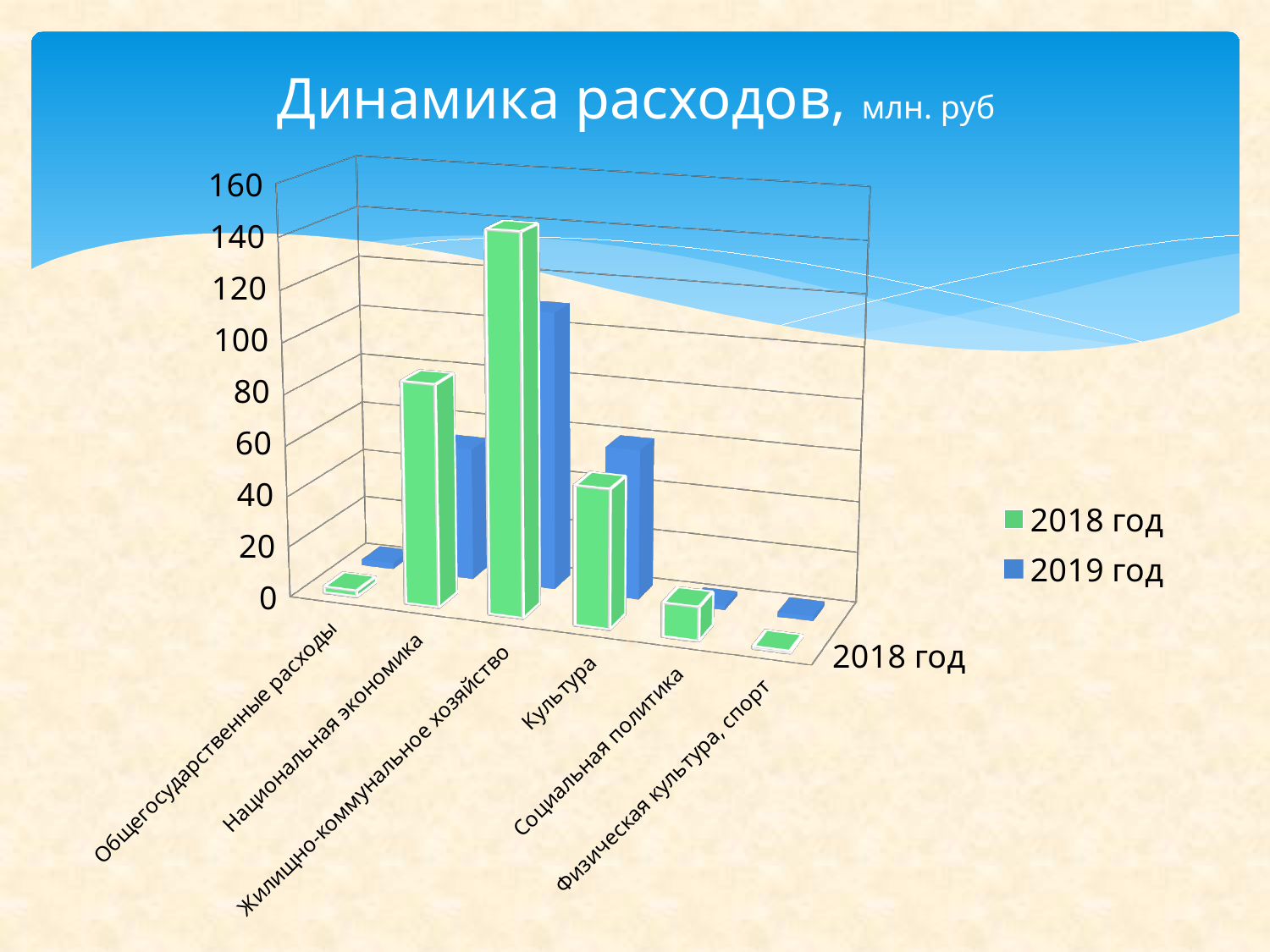
Which is larger for 2018 год: Культура or Социальная политика? Культура Which category has the highest value for 2018 год? Жилищно-коммунальное хозяйство Is the 2018 год value for Культура greater or less than 20? greater Is the 2018 год value for Жилищно-коммунальное хозяйство greater or less than 100? greater Is the 2018 год value for Социальная политика greater or less than 40? less Which category has the highest value for 2019 год? Жилищно-коммунальное хозяйство Which series is shown in green? 2018 год How many expenditure categories are shown on the x axis? 6 How many series does the legend list? 2 What kind of chart is shown on the slide? bar chart What is the title of the chart? Динамика расходов, млн. руб